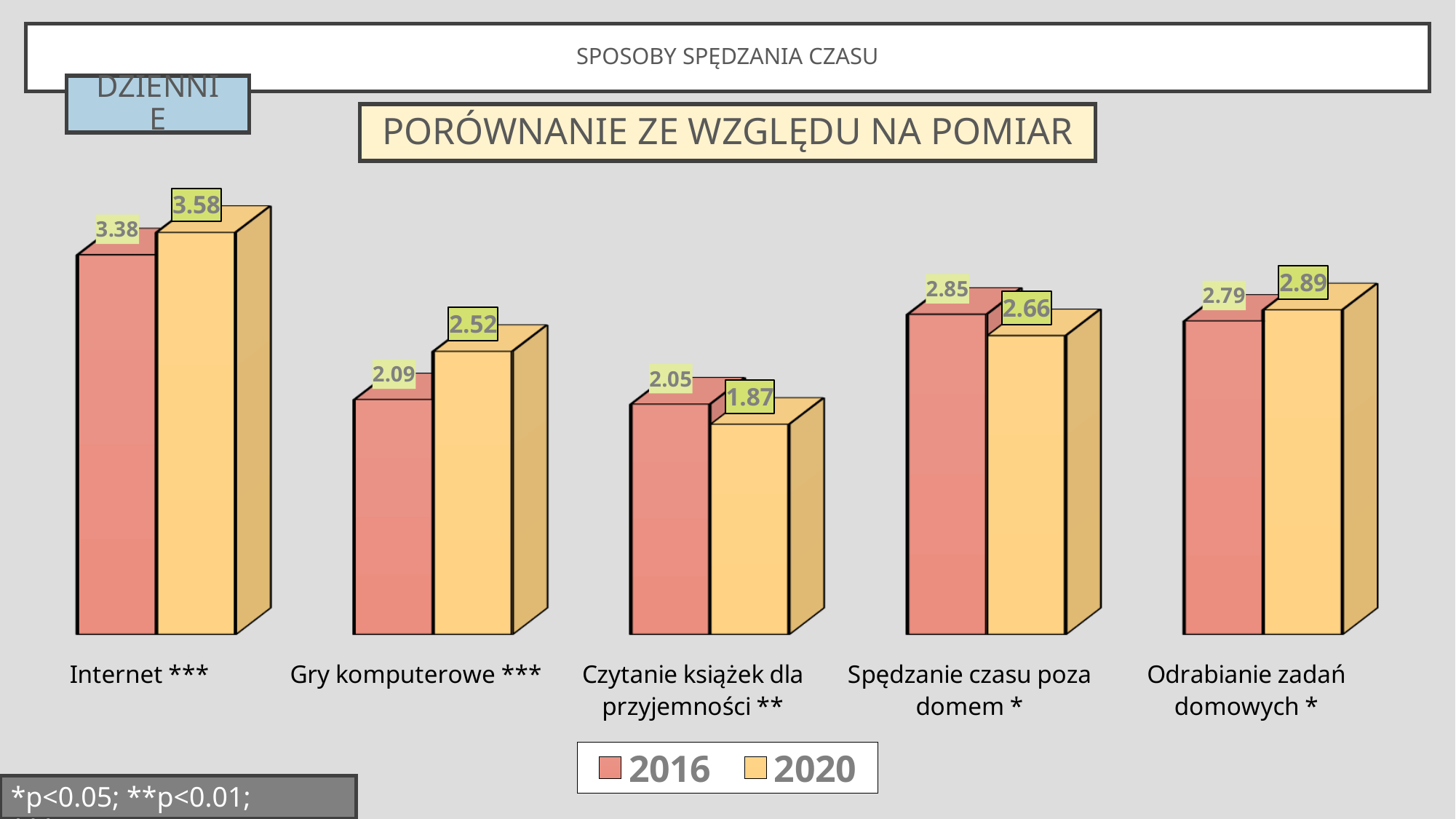
Which colour represents the 2020 series in the legend? Yellow/orange What is the 2016 value for Spędzanie czasu poza domem *? 2.85 How many series does the legend list? 2 What kind of chart is shown on the slide? Bar chart What is the difference between the 2020 and 2016 values for Gry komputerowe ***? 0.43 For Spędzanie czasu poza domem *, which year has the larger value, 2016 or 2020? 2016 Which category has the lowest 2016 value? Czytanie książek dla przyjemności ** Which category has the highest 2020 value? Internet *** What is the 2020 value for Czytanie książek dla przyjemności **? 1.87 What is the 2016 value for Internet ***? 3.38 How many categories are shown on the x axis? 5 What is the 2020 value for Gry komputerowe ***? 2.52